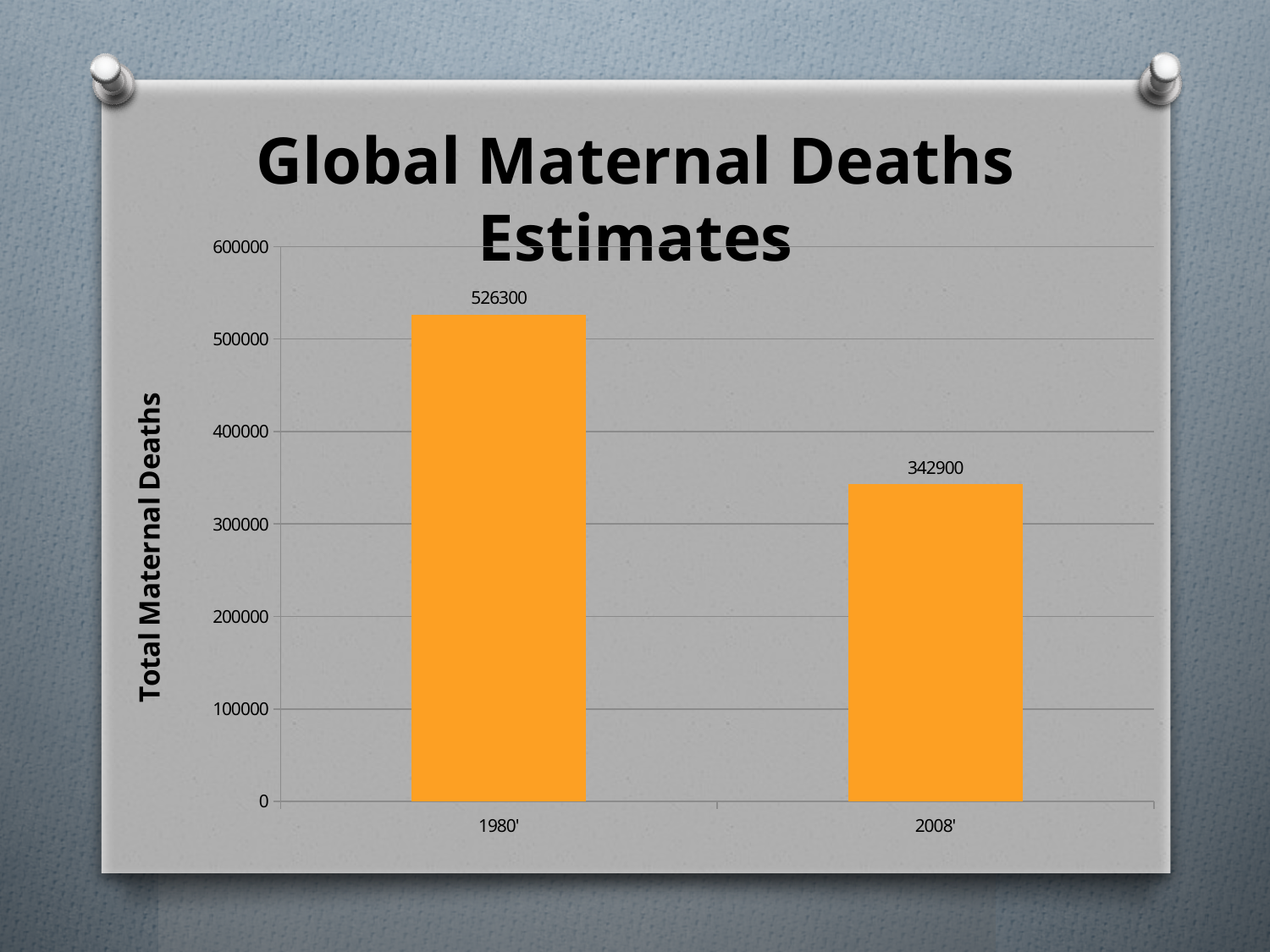
Do the values rise or fall from 1980' to 2008'? fall Which category has the highest value in the chart? 1980' Which is larger, the value for 1980' or the value for 2008'? 1980' What is the label of the vertical axis of the chart? Total Maternal Deaths Which category has the lowest value in the chart? 2008' How many categories are shown on the x axis of the chart? 2 What is the value for 1980' in the Global Maternal Deaths Estimates chart? 526300 Is the value for 2008' greater or less than 400000? less What kind of chart is shown on the slide? bar chart What is the value for 2008' in the Global Maternal Deaths Estimates chart? 342900 Is the value for 1980' greater or less than 500000? greater What is the difference between the values for 1980' and 2008'? 183400